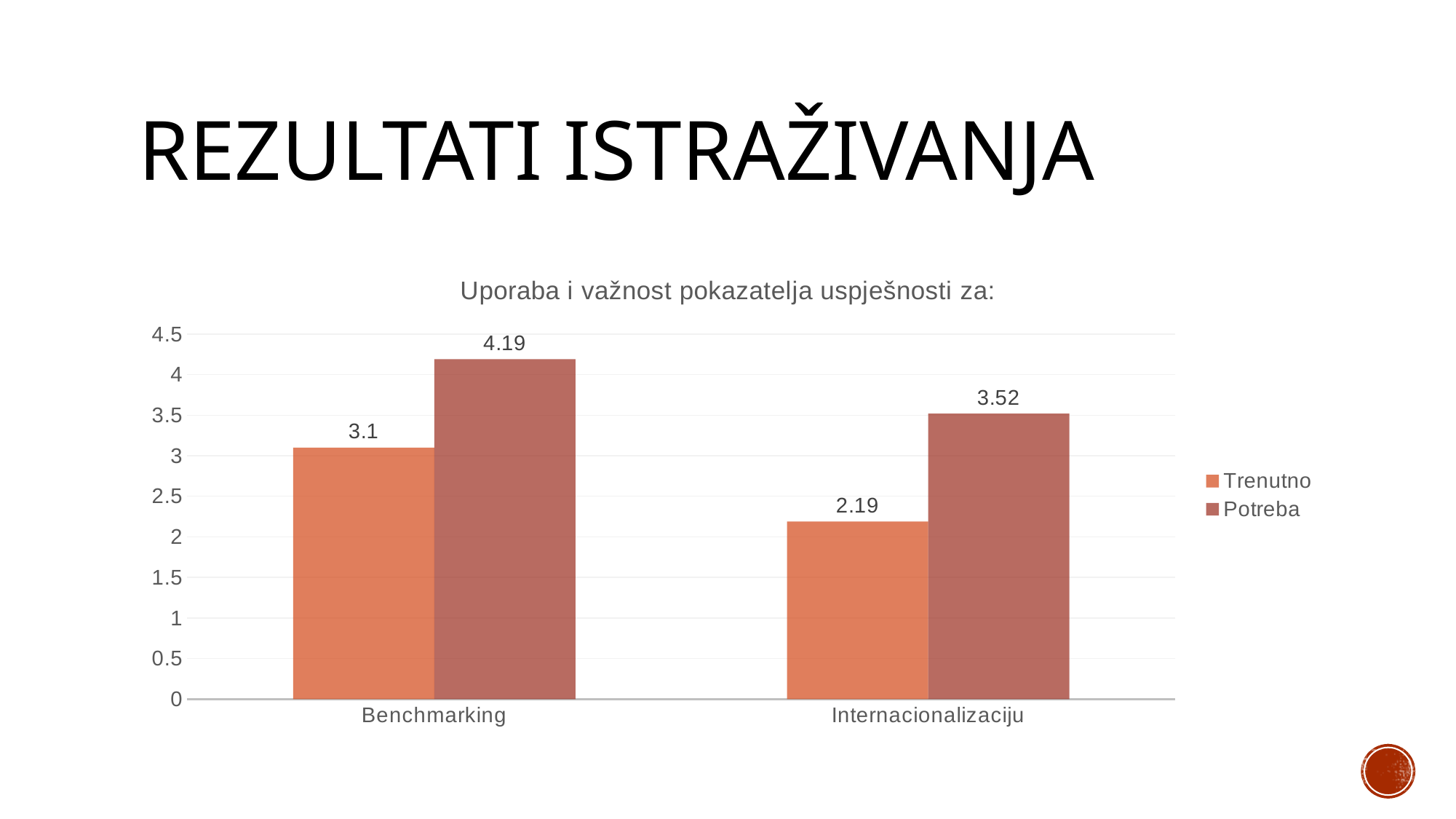
How many series does the legend list? 2 What is the difference between the Potreba and Trenutno values for Benchmarking? 1.09 What is the Potreba value for Benchmarking? 4.19 What is the Trenutno value for Benchmarking? 3.1 What is the Trenutno value for Internacionalizaciju? 2.19 Which is larger for Internacionalizaciju, Trenutno or Potreba? Potreba Which category has the lowest Trenutno value? Internacionalizaciju How many categories are shown on the x axis? 2 Which category has the highest Potreba value? Benchmarking What is the Potreba value for Internacionalizaciju? 3.52 What kind of chart is shown on the slide? bar chart Is the Trenutno value for Internacionalizaciju greater or less than 2.5? less